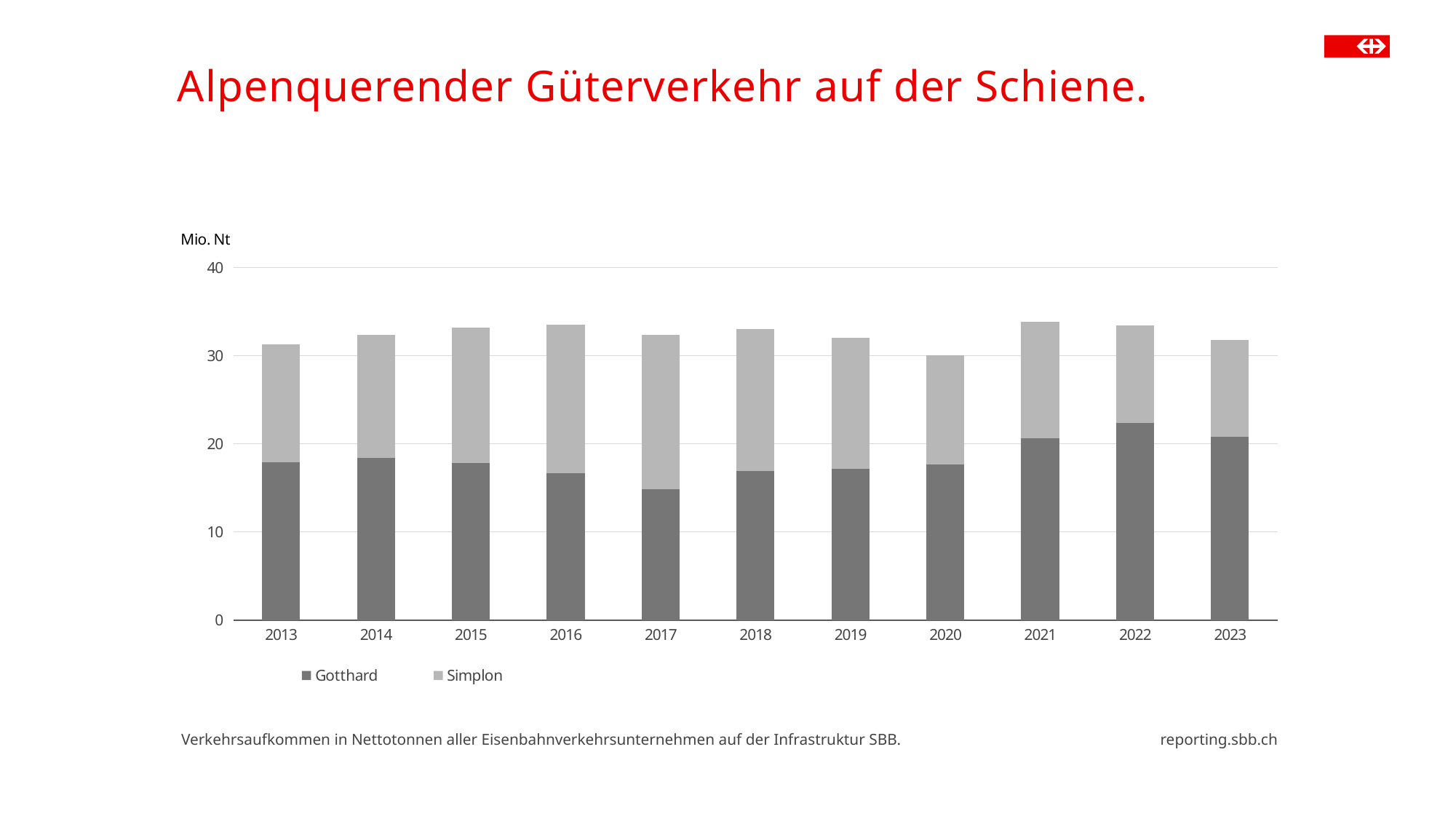
Which is larger, the Gotthard value for 2021 or the Gotthard value for 2013? 2021 How many years are shown on the x axis of the chart? 11 How many series does the chart's legend list? 2 Is the Gotthard value for 2022 greater or less than 20? greater Is the total stacked bar for 2013 greater or less than 30? greater In which year is the Gotthard value highest? 2022 In which year is the total stacked bar (Gotthard plus Simplon) lowest? 2020 What kind of chart is shown on the slide? Stacked bar chart Is the Gotthard value for 2017 greater or less than 20? less What unit is shown on the y axis of the chart? Mio. Nt In which year is the Gotthard value lowest? 2017 Which two series are listed in the chart's legend? Gotthard and Simplon